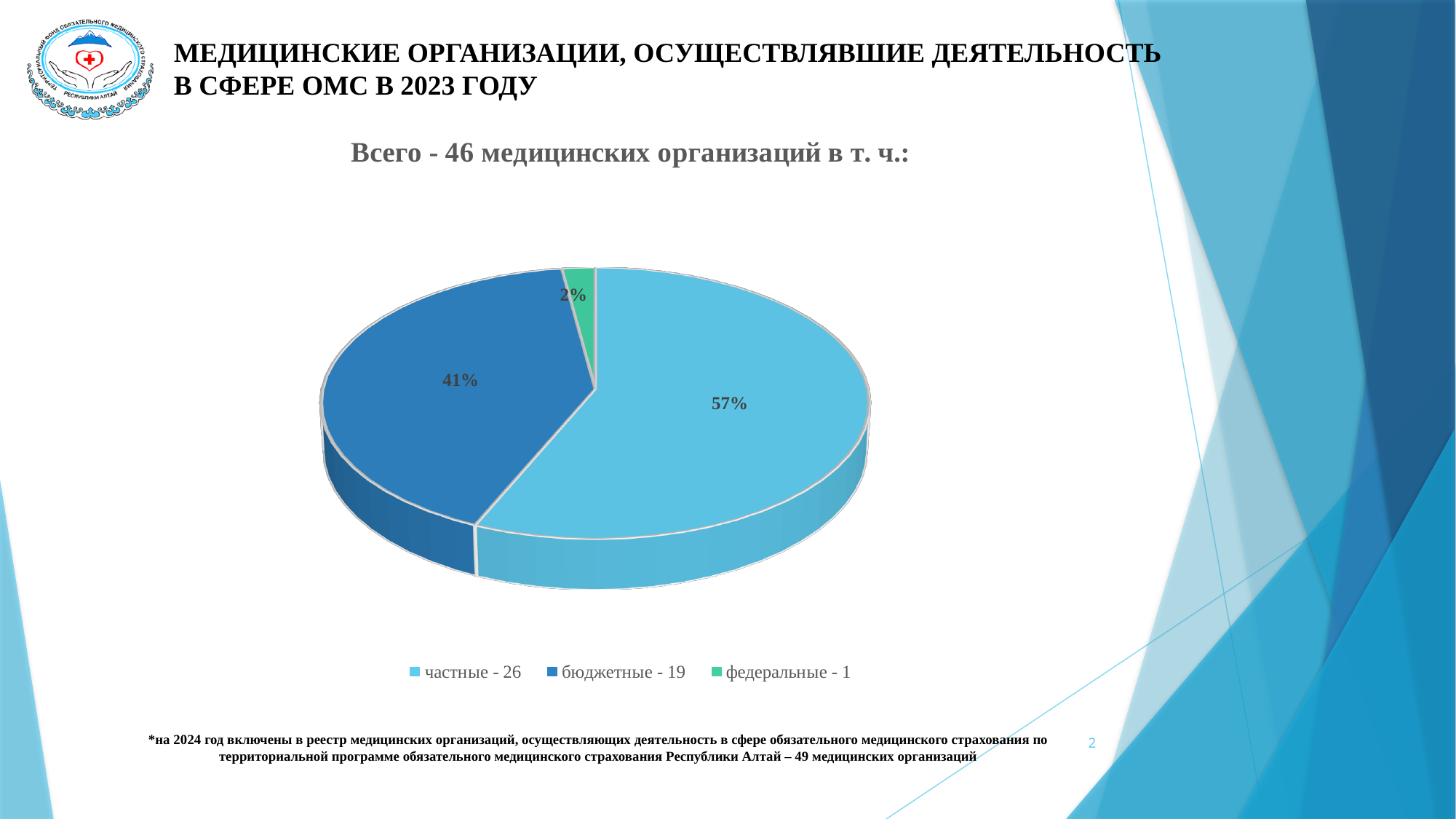
How many organisations does the legend give for частные? 26 What total number of medical organisations is stated in the chart title? 46 What is the difference in percentage points between the частные and бюджетные slices? 16 What kind of chart is shown on the slide? pie chart What percentage share does the федеральные slice have? 2% How many categories does the pie chart have? 3 How many organisations does the legend give for бюджетные? 19 What percentage share does the частные slice have? 57% What percentage share does the бюджетные slice have? 41% Which category has the smallest slice of the pie? федеральные How many organisations does the legend give for федеральные? 1 Which category has the largest slice of the pie? частные